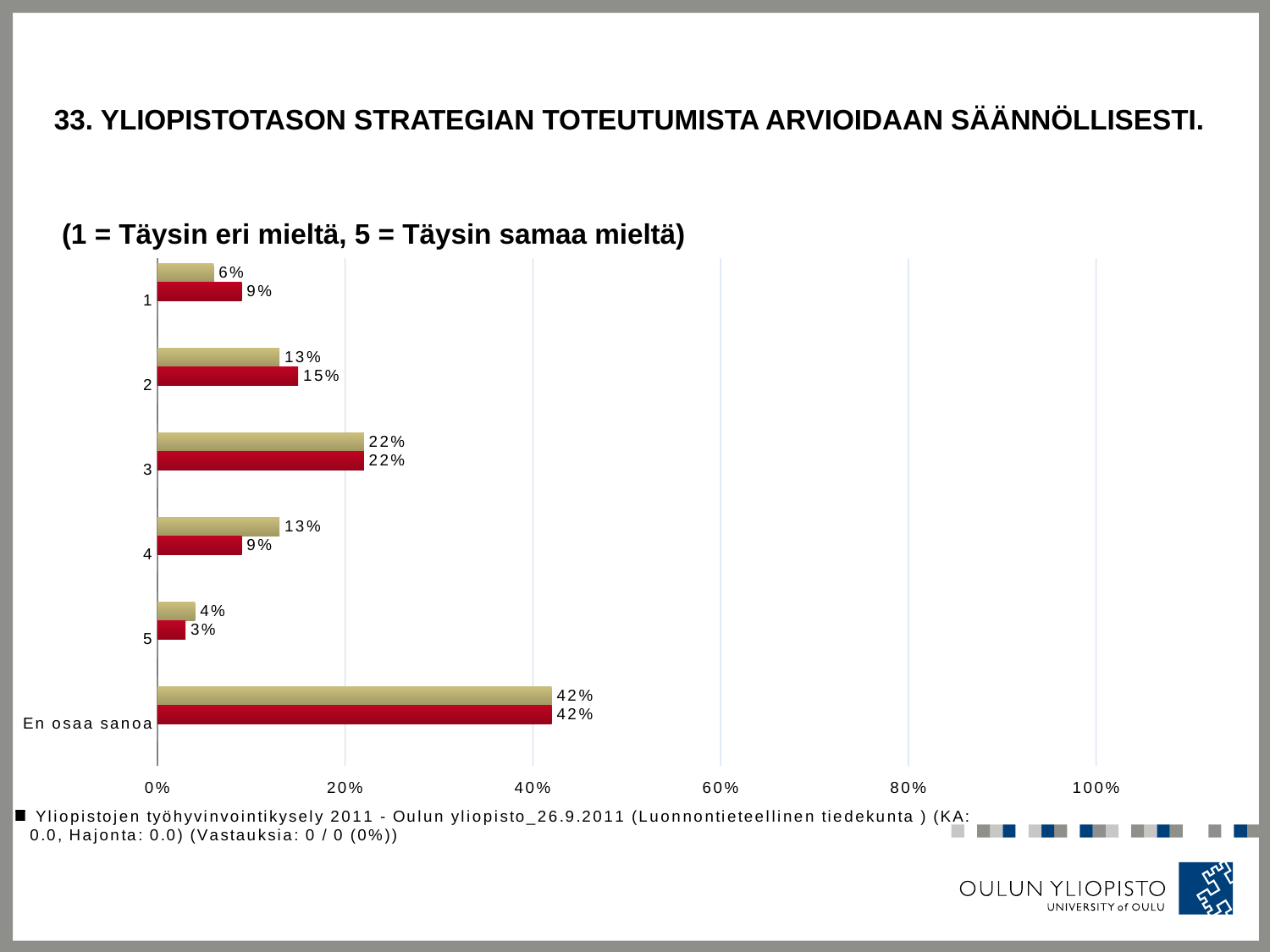
What is the value of the tan (upper) bar for category 2? 13% Which category has the lowest value for the tan (upper) bars? 5 For category 2, what is the difference between the red bar (15%) and the tan bar (13%)? 2 percentage points Is the value of the tan bar for "En osaa sanoa" greater or less than 40%? greater What is the value of the red bar for category 1? 9% Which category has the lowest value for the red bars? 5 What kind of chart is shown on the slide? Bar chart For category 4, which bar is larger, the tan (upper) bar or the red (lower) bar? The tan (upper) bar How many categories are shown on the vertical axis of the chart? 6 What is the value of the red bar for "En osaa sanoa"? 42% Which category has the highest value for the red bars? En osaa sanoa What is the value of the tan (upper) bar for category 3? 22%